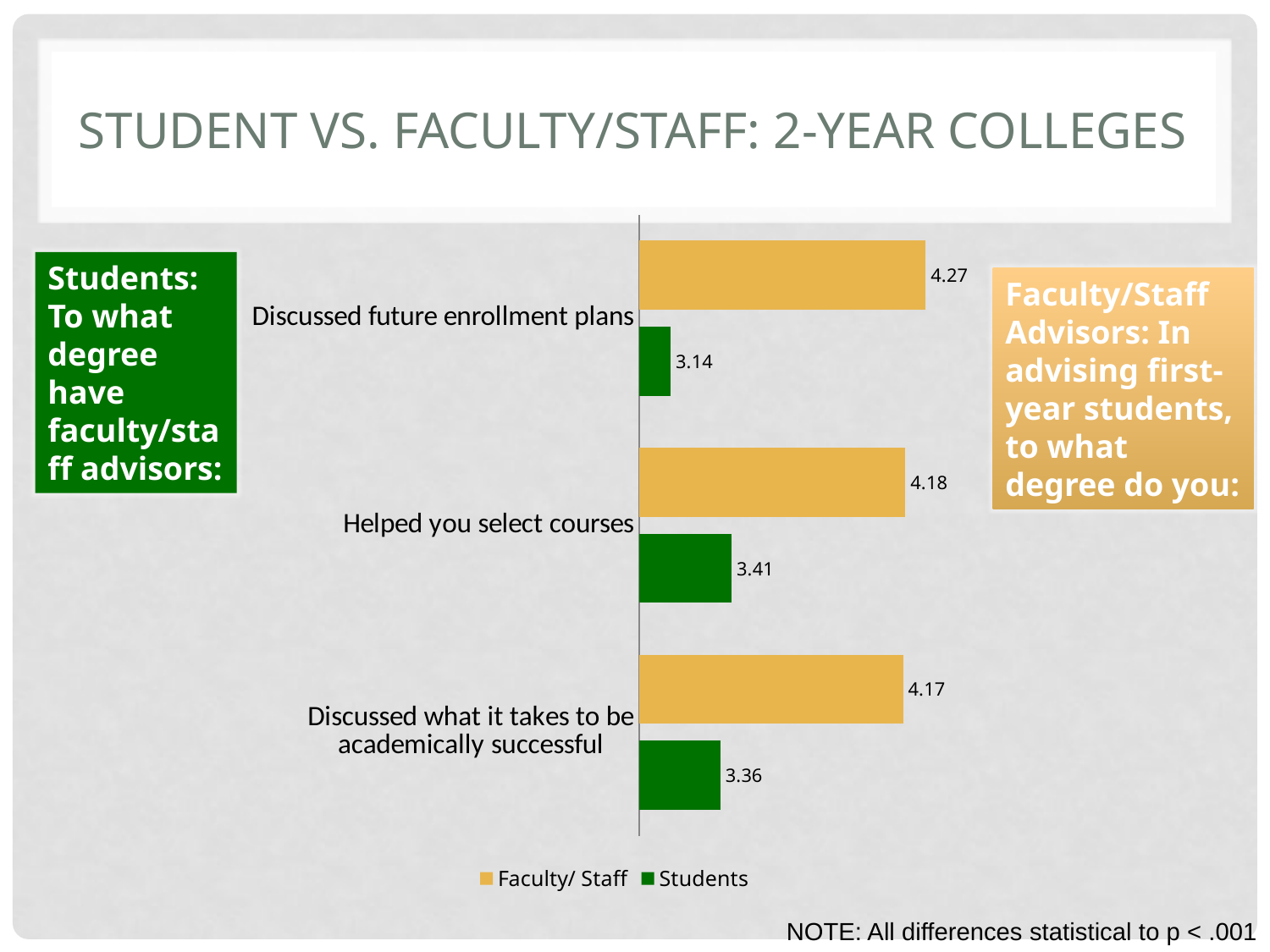
Which colour represents the Students series? Green What is the difference between the Faculty/ Staff and Students values for "Helped you select courses"? 0.77 What is the difference between the Faculty/ Staff and Students values for "Discussed future enrollment plans"? 1.13 How many categories are shown on the chart? 3 For "Discussed what it takes to be academically successful", which is larger: the Faculty/ Staff value or the Students value? Faculty/ Staff What kind of chart is shown on the slide? Bar chart Which category has the lowest Students value? Discussed future enrollment plans How many series does the legend list? 2 What is the Faculty/ Staff value for "Discussed future enrollment plans"? 4.27 What is the Students value for "Helped you select courses"? 3.41 Which category has the highest Faculty/ Staff value? Discussed future enrollment plans What is the Students value for "Discussed what it takes to be academically successful"? 3.36